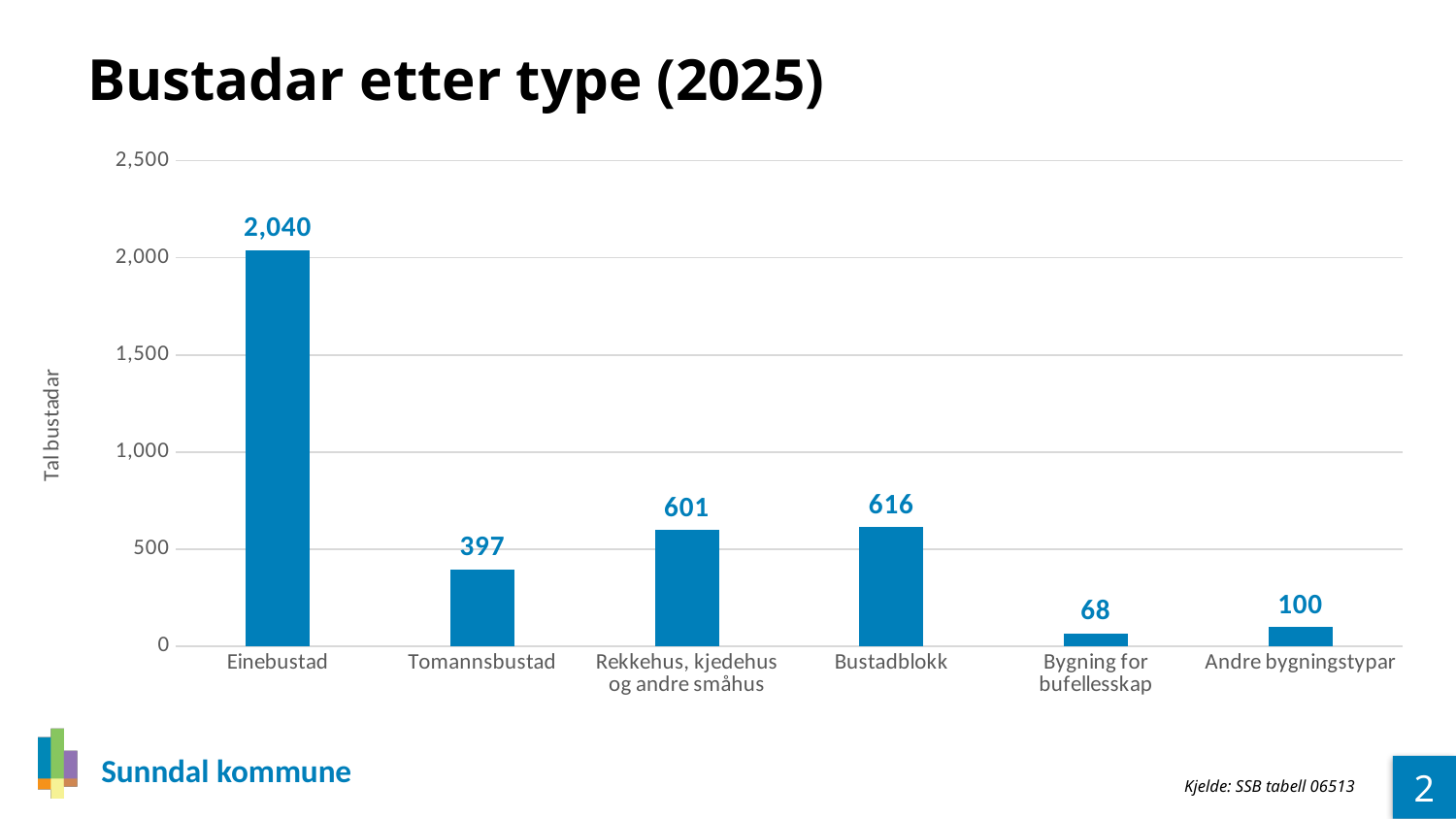
What is the value for Bygning for bufellesskap? 68 What kind of chart is this? Bar chart Which category has the highest value? Einebustad What is the value for Bustadblokk? 616 What is the value for Tomannsbustad? 397 What is the title of the chart? Bustadar etter type (2025) What is the difference between the values for Andre bygningstypar and Bygning for bufellesskap? 32 Which is larger, the value for Rekkehus, kjedehus og andre småhus or the value for Tomannsbustad? Rekkehus, kjedehus og andre småhus How many categories are shown on the x axis? 6 What is the value for Einebustad? 2,040 Which category has the lowest value? Bygning for bufellesskap What is the difference between the values for Einebustad and Tomannsbustad? 1,643